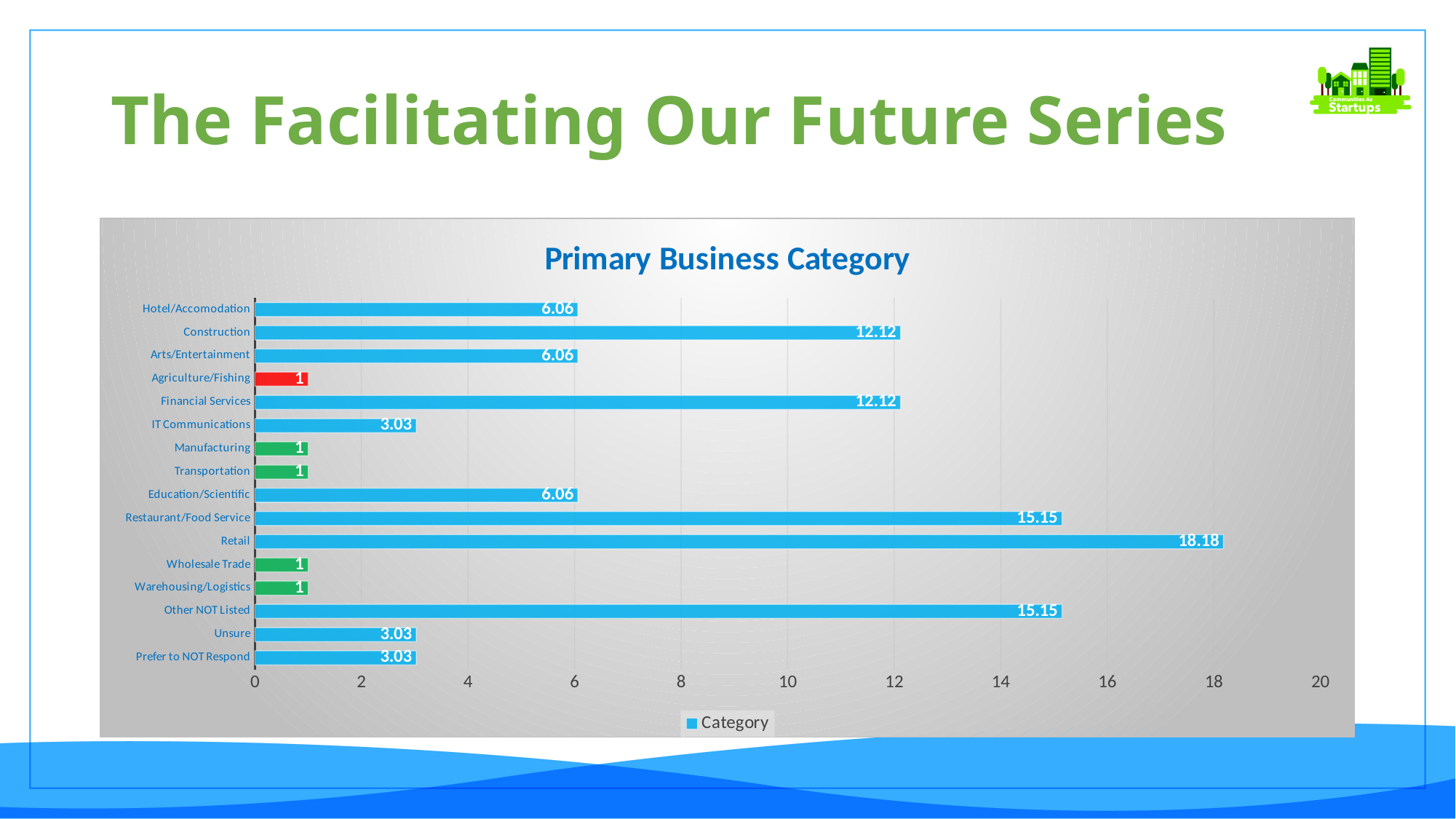
What is the value for Construction? 12.12 What kind of chart is shown on the slide? bar chart What is the value for Retail? 18.18 How many series does the legend list? 1 What is the value for IT Communications? 3.03 Is the value for Other NOT Listed greater or less than 14? greater How many categories are shown on the chart? 16 What is the title of the chart? Primary Business Category Which category's bar is coloured red? Agriculture/Fishing Which category has the highest value? Retail What is the difference between the values for Retail and Restaurant/Food Service? 3.03 Which is larger, the value for Financial Services or the value for Hotel/Accomodation? Financial Services